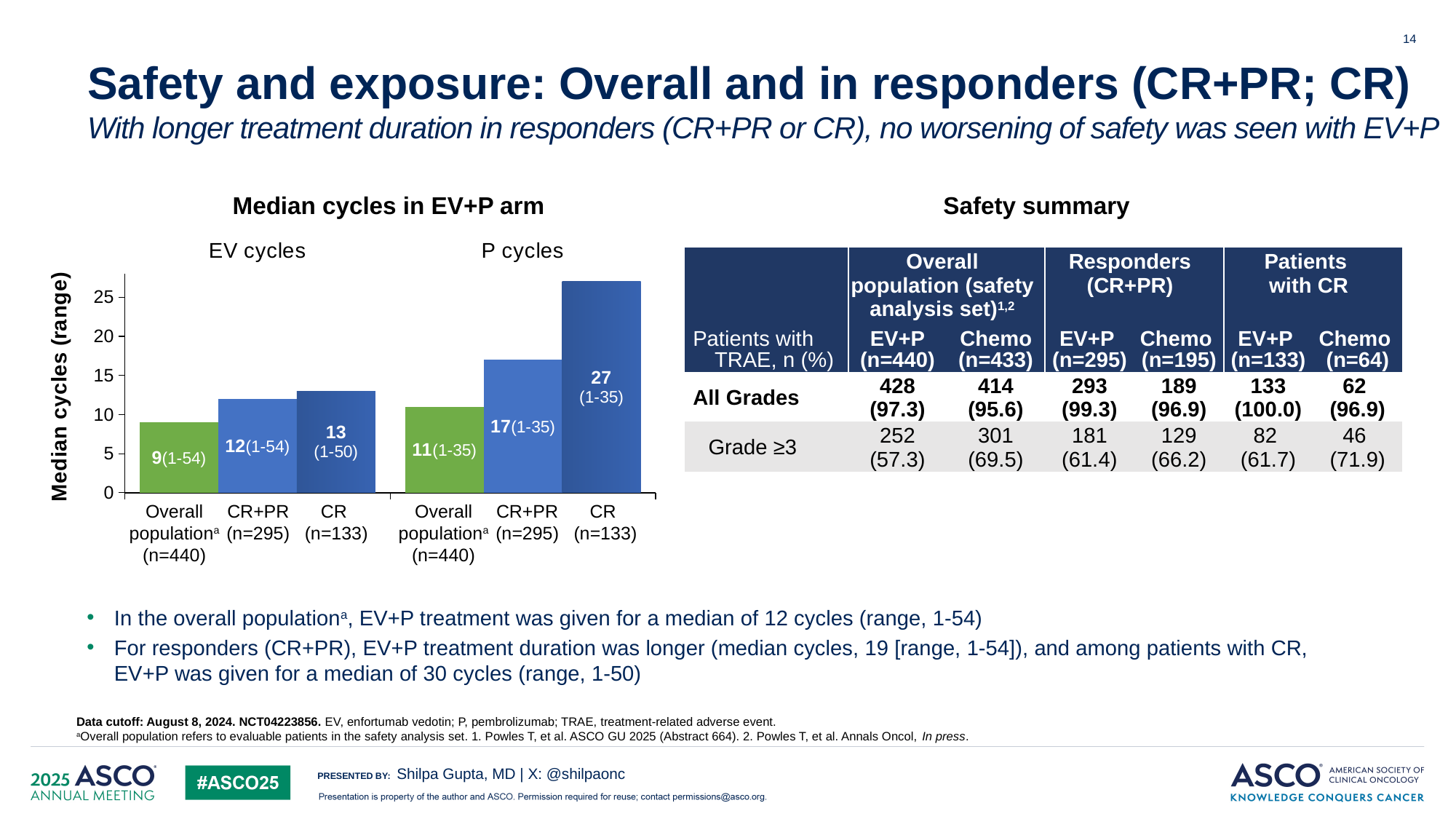
In the Median cycles in EV+P arm chart, what is the median number of EV cycles for responders (CR+PR, n=295)? 12 What type of chart is the Median cycles in EV+P arm chart? Bar chart In the Median cycles in EV+P arm chart, what is the median number of P cycles for patients with CR (n=133)? 27 In the Median cycles in EV+P arm chart, for patients with CR, which is larger: the median EV cycles or the median P cycles? P cycles In the Median cycles in EV+P arm chart, which group has the highest median number of P cycles? CR (n=133) How many bars are plotted in the Median cycles in EV+P arm chart? 6 In the Median cycles in EV+P arm chart, how many more median P cycles did patients with CR receive than the overall population? 16 In the Median cycles in EV+P arm chart, is the median number of P cycles for patients with CR greater or less than 25? greater In the Median cycles in EV+P arm chart, what is the median number of P cycles for responders (CR+PR, n=295)? 17 In the Median cycles in EV+P arm chart, what is the median number of EV cycles for the overall population (n=440)? 9 In the Median cycles in EV+P arm chart, which group has the lowest median number of EV cycles? Overall population (n=440) In the Median cycles in EV+P arm chart, what is the difference in median EV cycles between responders (CR+PR) and the overall population? 3